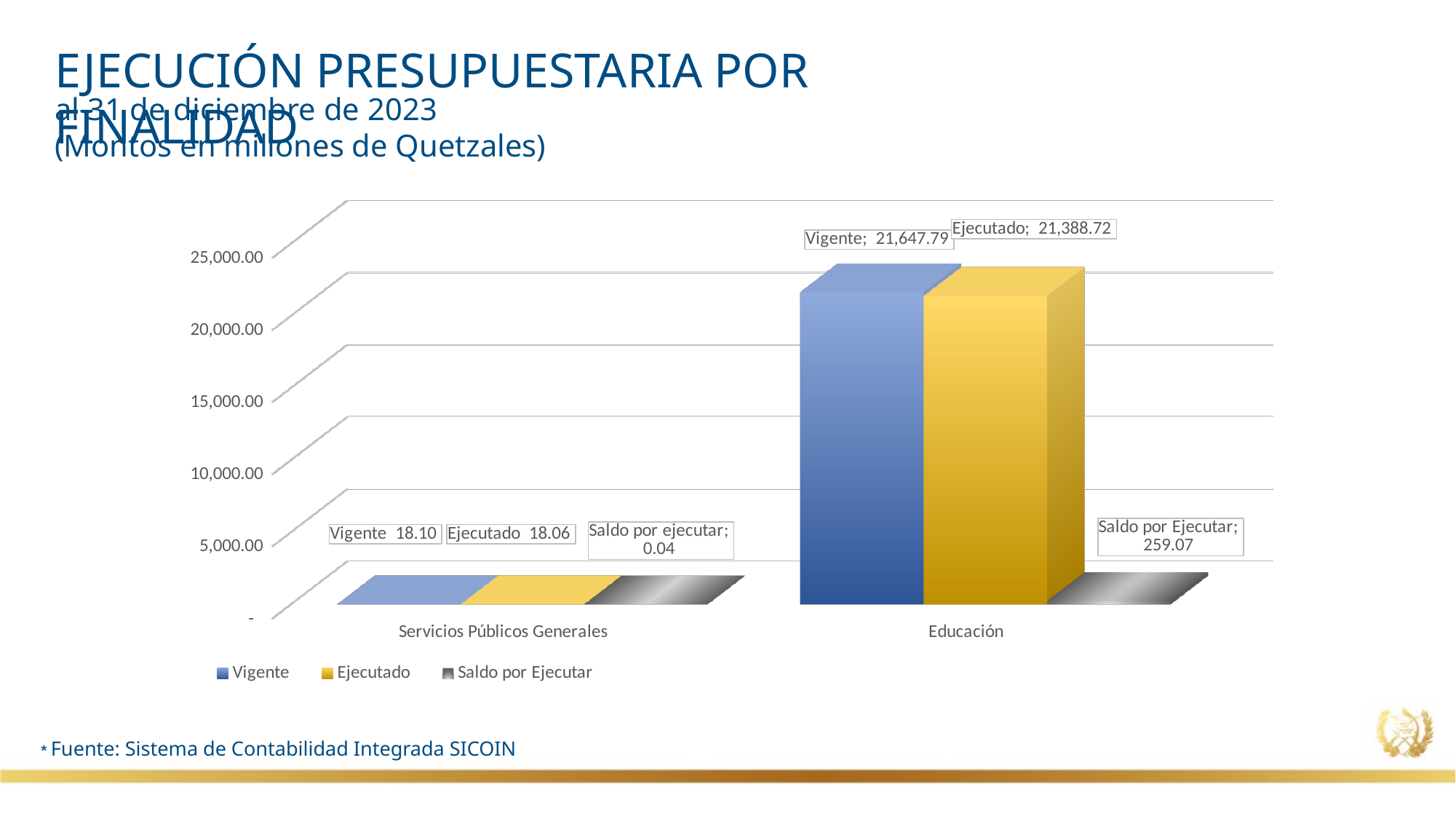
What is the Saldo por ejecutar value for Servicios Públicos Generales? 0.04 What is the Saldo por Ejecutar value for Educación? 259.07 How many series does the legend list? 3 What is the Ejecutado value for Educación? 21,388.72 What is the difference between the Vigente and Ejecutado values for Educación? 259.07 What is the Vigente value for Servicios Públicos Generales? 18.10 What kind of chart is shown on the slide? Bar chart Is the Ejecutado value for Educación greater or less than 20,000.00? greater Which category has the higher Vigente value? Educación What is the Vigente value for Educación? 21,647.79 What is the Ejecutado value for Servicios Públicos Generales? 18.06 How many categories are shown on the x axis? 2